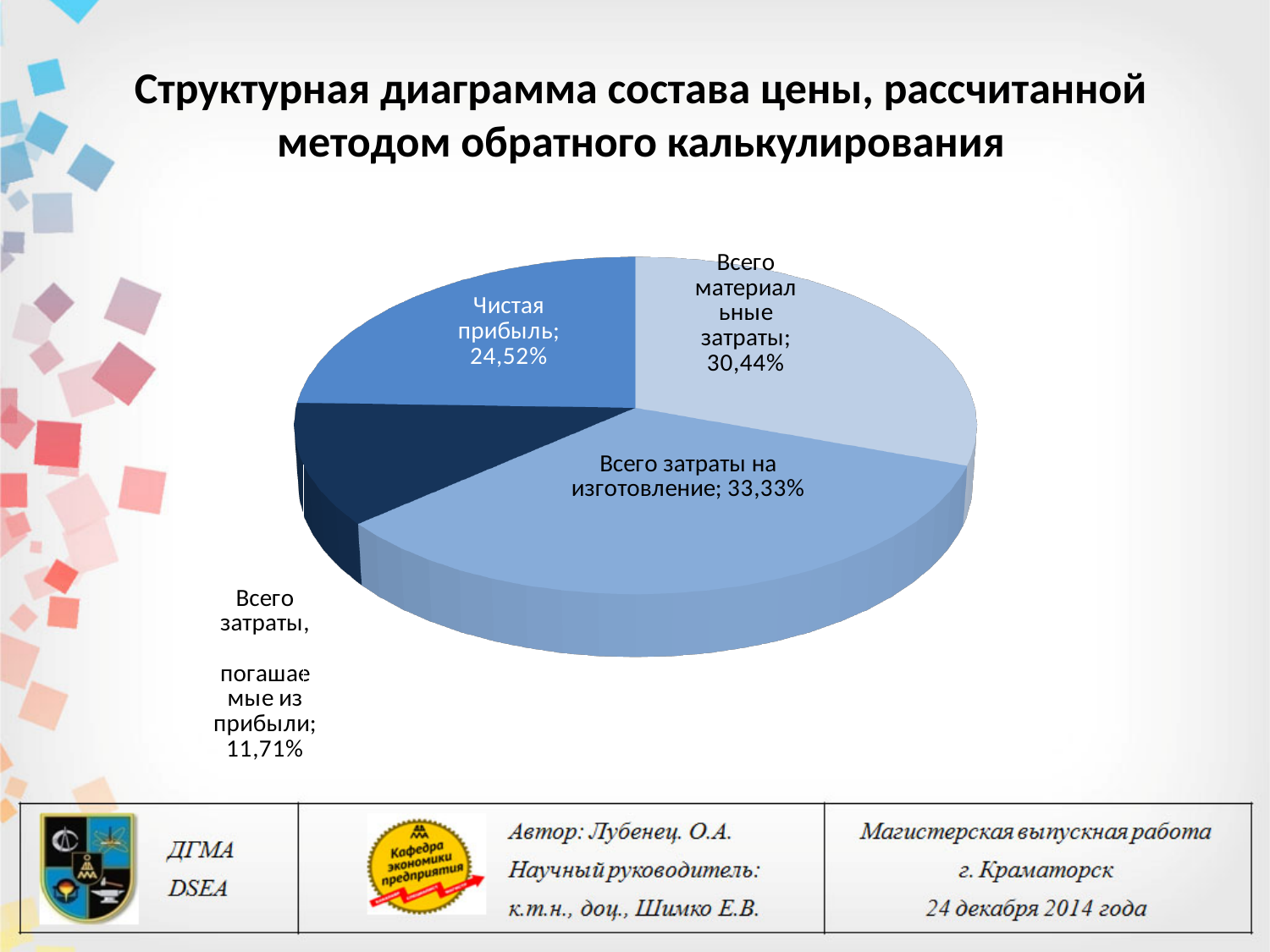
What share of the pie is labelled "Всего затраты на изготовление"? 33,33% What is the difference in percentage points between "Всего затраты на изготовление" and "Всего затраты, погашаемые из прибыли"? 21,62 What type of chart is shown on the slide? Pie chart How many slices does the pie chart have? 4 What is the difference in percentage points between "Всего материальные затраты" and "Чистая прибыль"? 5,92 What share of the pie is labelled "Всего материальные затраты"? 30,44% Which slice of the pie chart is the smallest? Всего затраты, погашаемые из прибыли Which is larger: the share for "Всего материальные затраты" or the share for "Чистая прибыль"? Всего материальные затраты What is the title of the chart on the slide? Структурная диаграмма состава цены, рассчитанной методом обратного калькулирования What share of the pie is labelled "Чистая прибыль"? 24,52% What share of the pie is labelled "Всего затраты, погашаемые из прибыли"? 11,71% Which slice of the pie chart is the largest? Всего затраты на изготовление